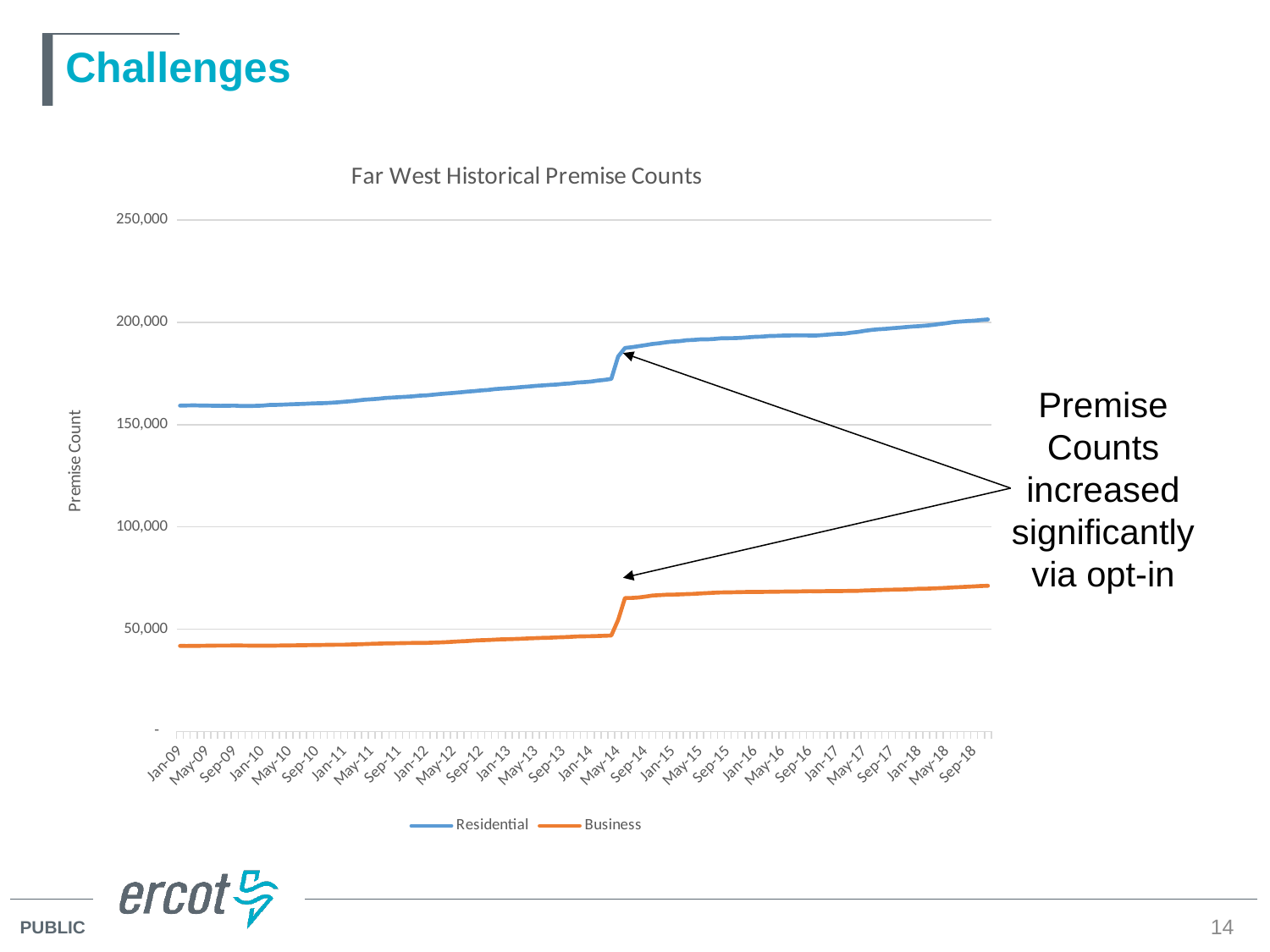
What are the two series named in the legend? Residential and Business Is the Business value at Jan-09 greater or less than 50,000? less Do the Residential premise counts rise or fall from Jan-09 to Sep-18? Rise How many series does the legend list? 2 Is the Residential value at Sep-18 greater or less than 150,000? greater Is the Business value at Sep-18 greater or less than 100,000? less Which series has the higher premise count throughout the chart, Residential or Business? Residential What kind of chart is shown on the slide? Line chart Do the Business premise counts rise or fall from Jan-09 to Sep-18? Rise What is the title of the chart? Far West Historical Premise Counts